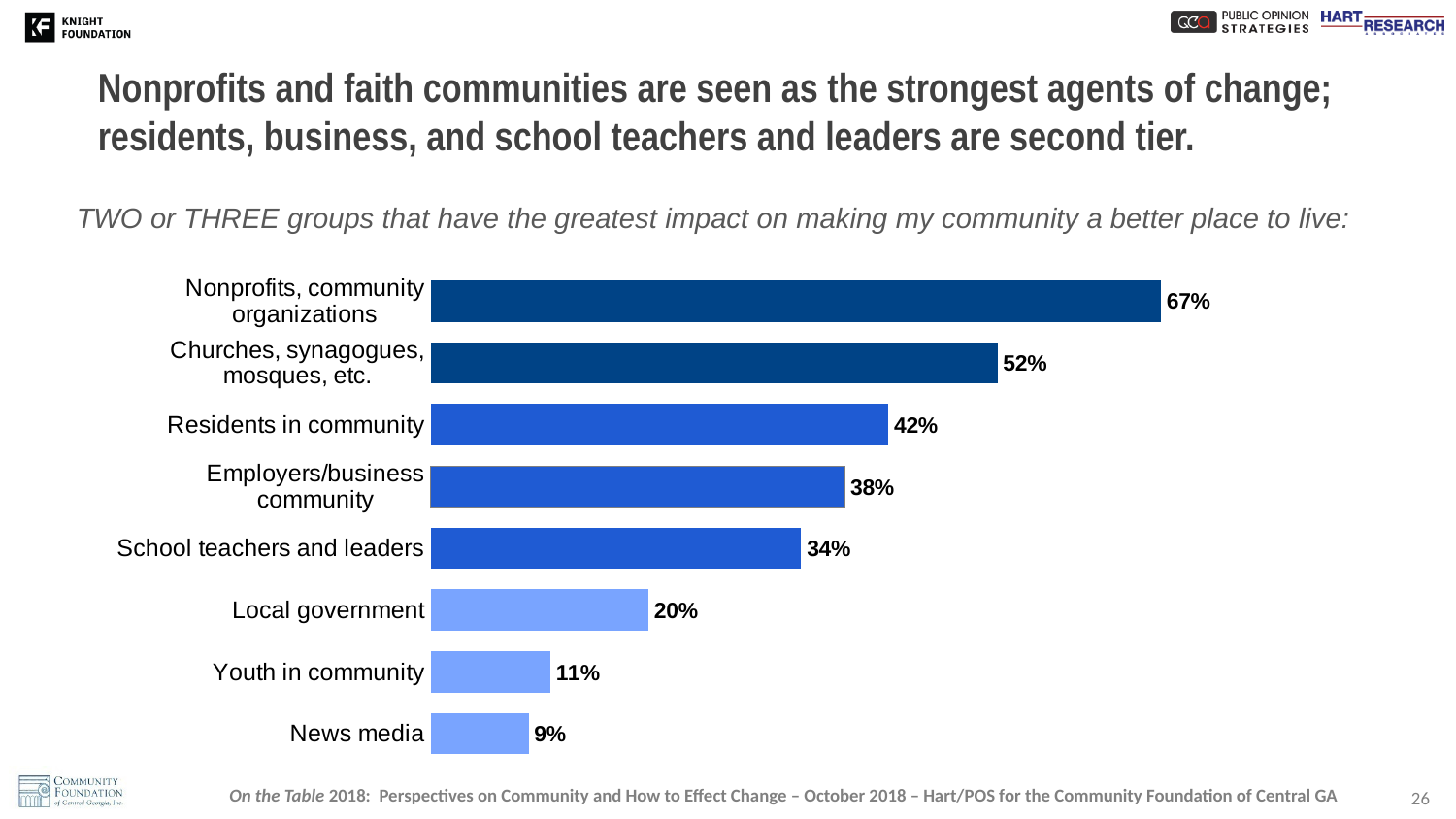
Which has a larger value: Residents in community or Employers/business community? Residents in community How many groups are shown in the chart? 8 Which group has the lowest value in the chart? News media What is the value shown for School teachers and leaders? 34% What type of chart is shown on the slide? Bar chart What percentage of respondents named nonprofits and community organizations as having the greatest impact? 67% What is the difference between the values for Employers/business community and Youth in community? 27 percentage points Which group has the highest value in the chart? Nonprofits, community organizations Do the values rise or fall going from the top bar to the bottom bar? Fall Which has a larger value: Youth in community or News media? Youth in community What is the difference between the values for Churches, synagogues, mosques, etc. and Residents in community? 10 percentage points What is the value shown for Local government? 20%